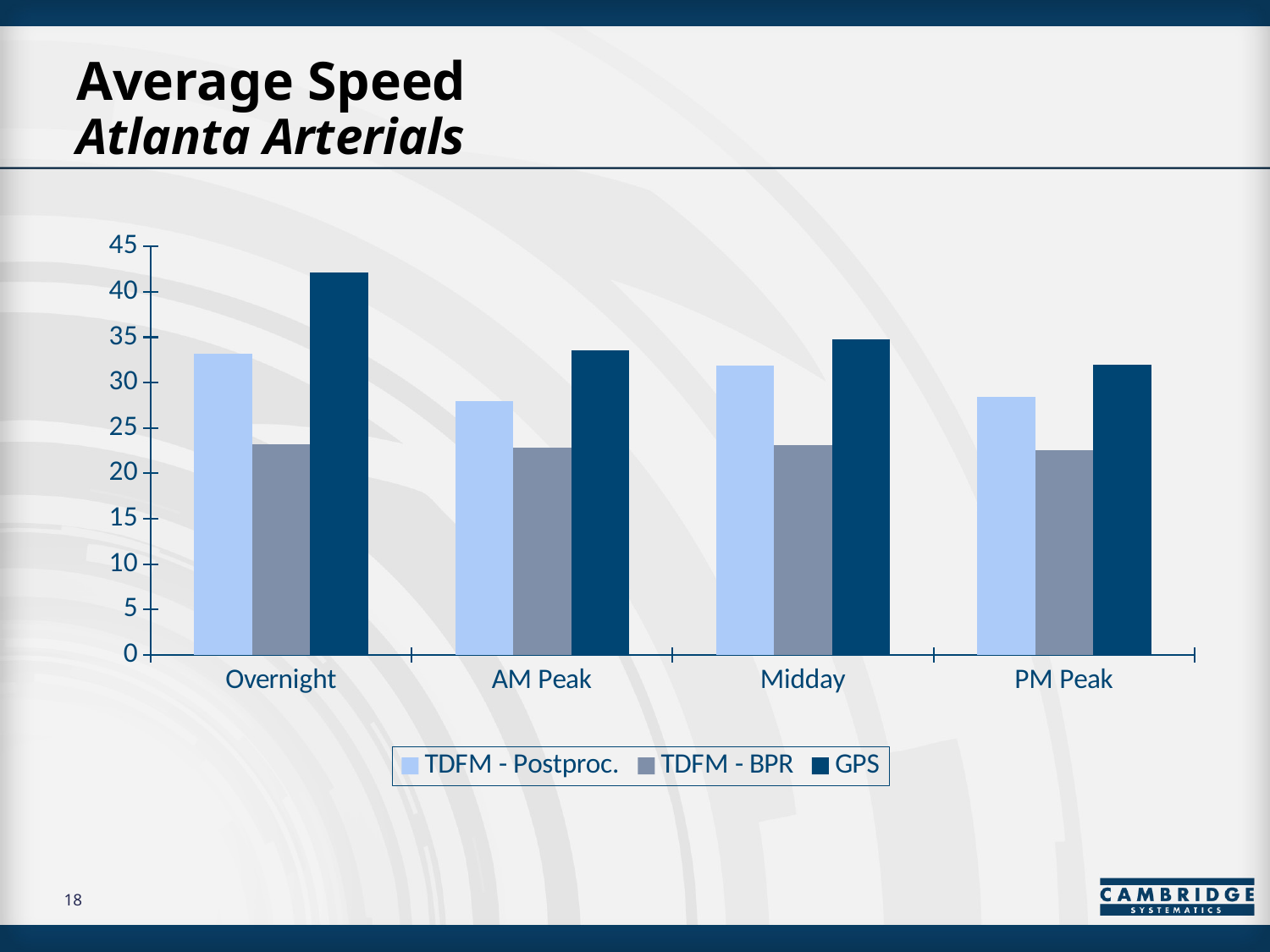
For AM Peak, which is larger: TDFM - Postproc. or TDFM - BPR? TDFM - Postproc. For Overnight, which is larger: the GPS value or the TDFM - Postproc. value? GPS What kind of chart is shown on the slide? bar chart Is the GPS value for Overnight greater or less than 40? greater Is the TDFM - BPR value for AM Peak greater or less than 25? less What are the three series listed in the legend? TDFM - Postproc., TDFM - BPR, GPS How many series does the legend list? 3 Is the TDFM - Postproc. value for Midday greater or less than 30? greater In which time period is the GPS average speed highest? Overnight Which series has the lowest value in every time period? TDFM - BPR How many time periods are shown on the x axis? 4